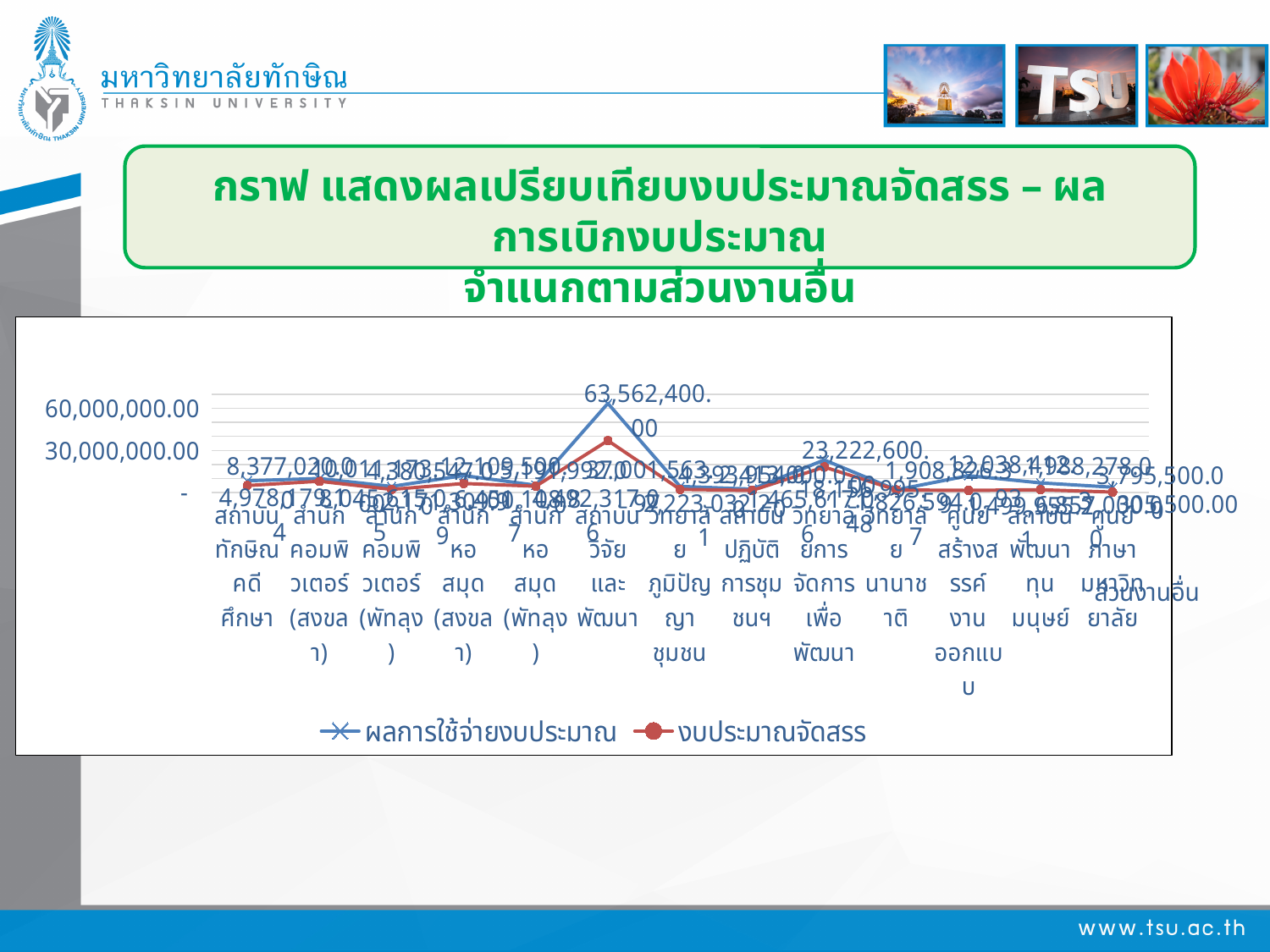
For สถาบันวิจัยและพัฒนา, which series has the higher value, ผลการใช้จ่ายงบประมาณ or งบประมาณจัดสรร? ผลการใช้จ่ายงบประมาณ Is the value of ผลการใช้จ่ายงบประมาณ for สถาบันทักษิณคดีศึกษา greater or less than 30,000,000.00? less What are the two series named in the legend? ผลการใช้จ่ายงบประมาณ and งบประมาณจัดสรร What is the value of ผลการใช้จ่ายงบประมาณ for วิทยาลัยการจัดการเพื่อพัฒนา? 23,222,600.00 How many series does the legend list? 2 What is the highest value labelled on the vertical axis? 60,000,000.00 What is the value of ผลการใช้จ่ายงบประมาณ for สถาบันวิจัยและพัฒนา? 63,562,400.00 How many units (categories) are plotted along the x axis? 13 Is the value of ผลการใช้จ่ายงบประมาณ for สถาบันวิจัยและพัฒนา greater or less than 60,000,000.00? greater Which unit has the highest value for ผลการใช้จ่ายงบประมาณ? สถาบันวิจัยและพัฒนา What kind of chart is shown on the slide? line chart